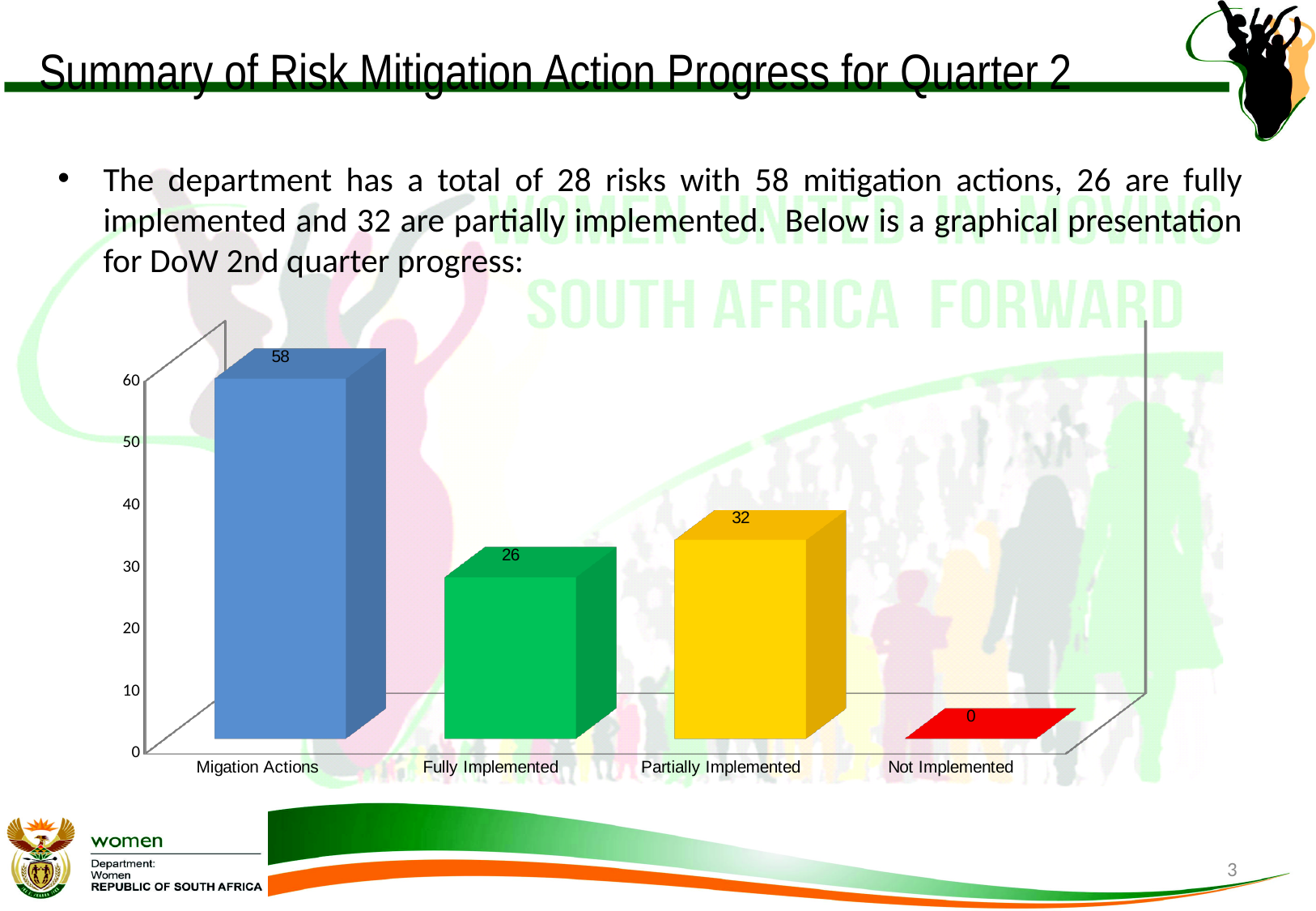
What is the difference between Migation Actions and Partially Implemented? 26 What is the value for Fully Implemented? 26 What is the value for Partially Implemented? 32 What kind of chart is shown on the slide? bar chart What colour is the bar for Partially Implemented? yellow What is the value for Not Implemented? 0 Which is larger, Fully Implemented or Partially Implemented? Partially Implemented Which category has the lowest value? Not Implemented What is the value for Migation Actions? 58 How many categories are shown on the x axis? 4 What is the difference between Partially Implemented and Fully Implemented? 6 Which category has the highest value? Migation Actions